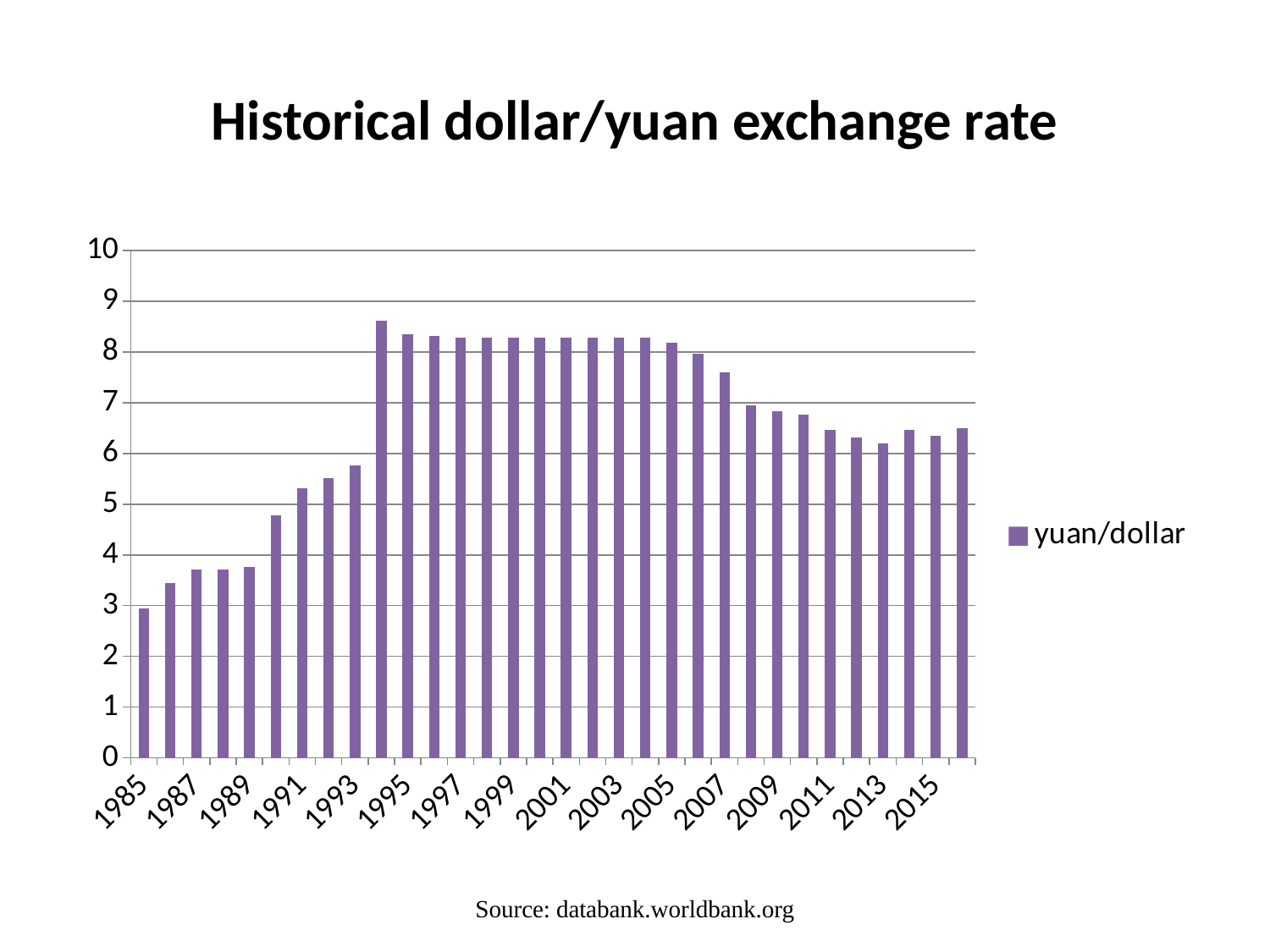
Which is larger, the value for 1994 or the value for 2016? 1994 What kind of chart is shown on the slide? bar chart Which year has the lowest yuan/dollar value? 1985 How many series does the legend list? 1 Is the value for 1994 greater or less than 8? greater Which year has the highest yuan/dollar value? 1994 Is the value for 1987 greater or less than 4? less Is the value for 2013 greater or less than 6? greater What is the title of the chart? Historical dollar/yuan exchange rate What is the name of the series shown in the legend? yuan/dollar Do the values rise or fall from 1985 to 1994? rise